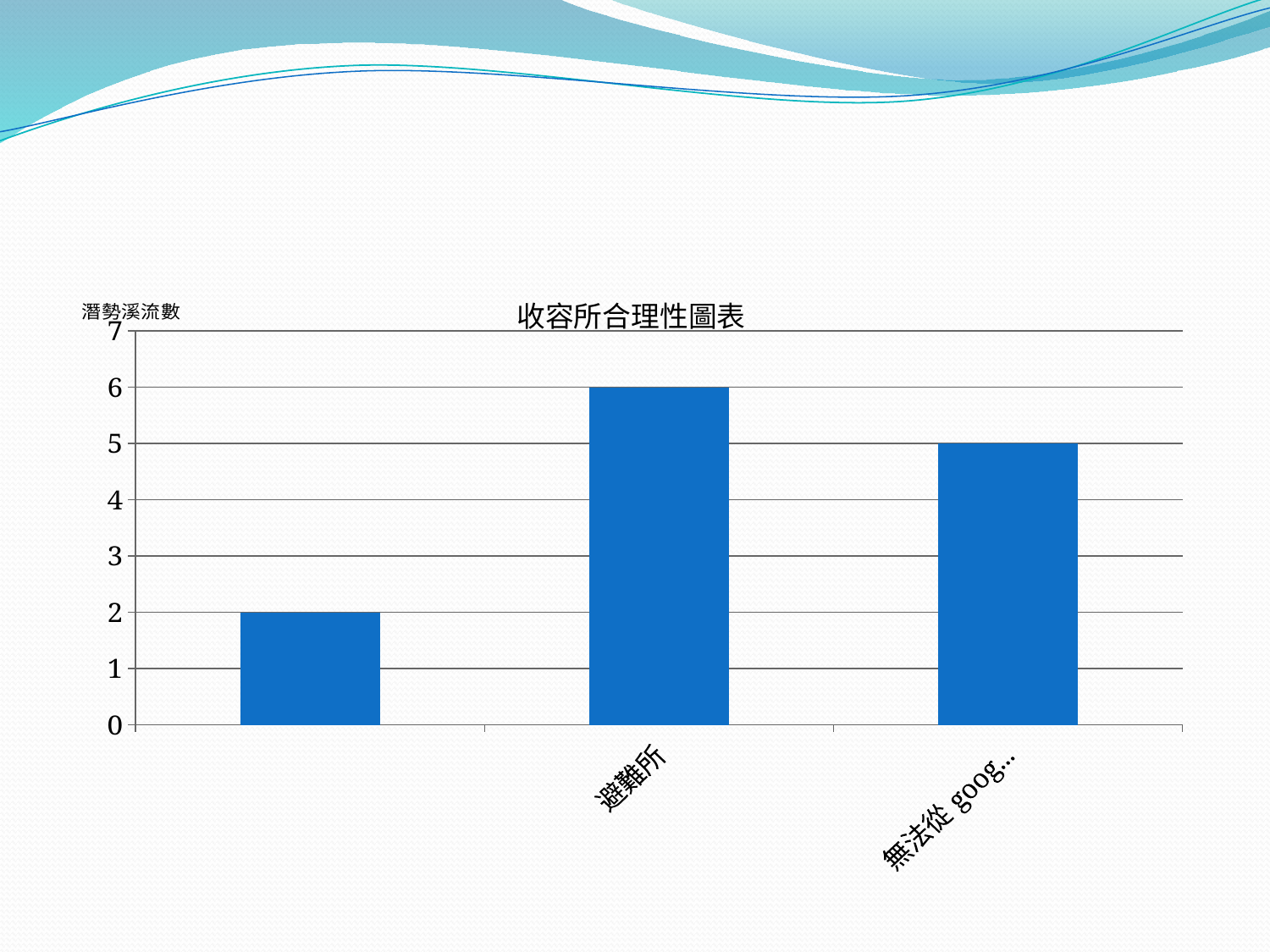
Is the value for 無法從 goog… greater or less than 4? greater What is the value of the leftmost bar in the chart? 2 Which is larger, the value for 避難所 or the value for 無法從 goog…? 避難所 What is the difference between the values for 避難所 and 無法從 goog…? 1 Which category has the highest value? 避難所 What is the title of the chart? 收容所合理性圖表 What is the value for 避難所? 6 What kind of chart is shown on the slide? bar chart What is the value for the category labelled 無法從 goog…? 5 What is the label on the vertical axis of the chart? 潛勢溪流數 How many bars are plotted in the chart? 3 Is the value for 避難所 greater or less than 5? greater